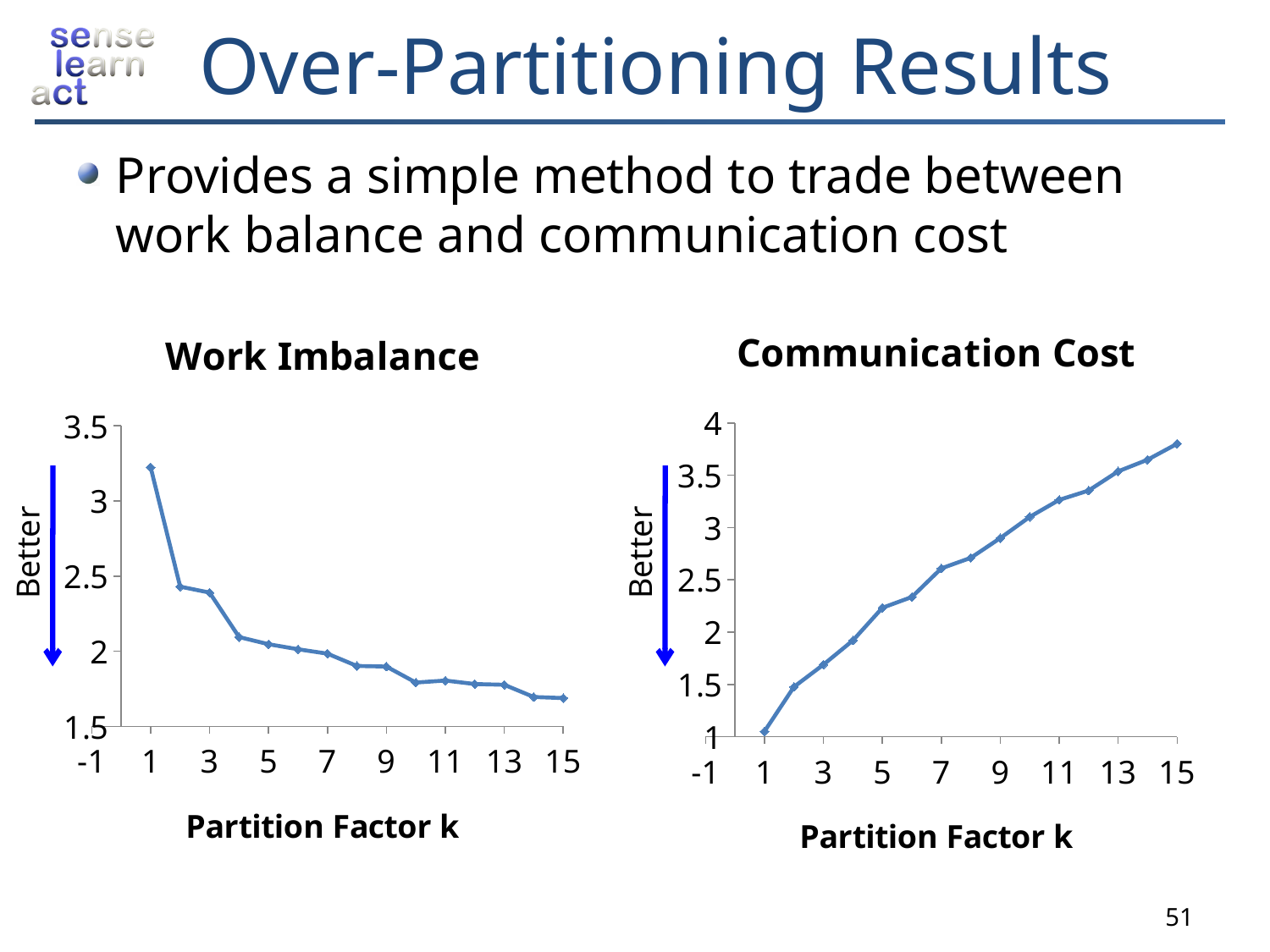
What is the x-axis title of the Communication Cost chart? Partition Factor k In the Work Imbalance chart, at which partition factor k is the value highest? 1 What kind of chart is the Work Imbalance chart? line chart In the Work Imbalance chart, do the values rise or fall as the partition factor k increases? fall In the Work Imbalance chart, is the value at k = 15 greater or less than 2? less In the Communication Cost chart, is the value at k = 15 greater or less than 3.5? greater In the Communication Cost chart, which is larger: the value at k = 3 or the value at k = 11? k = 11 In the Communication Cost chart, at which partition factor k is the value highest? 15 In the Communication Cost chart, is the value at k = 1 greater or less than 1.5? less In the Communication Cost chart, at which partition factor k is the value lowest? 1 In the Communication Cost chart, do the values rise or fall as the partition factor k increases? rise